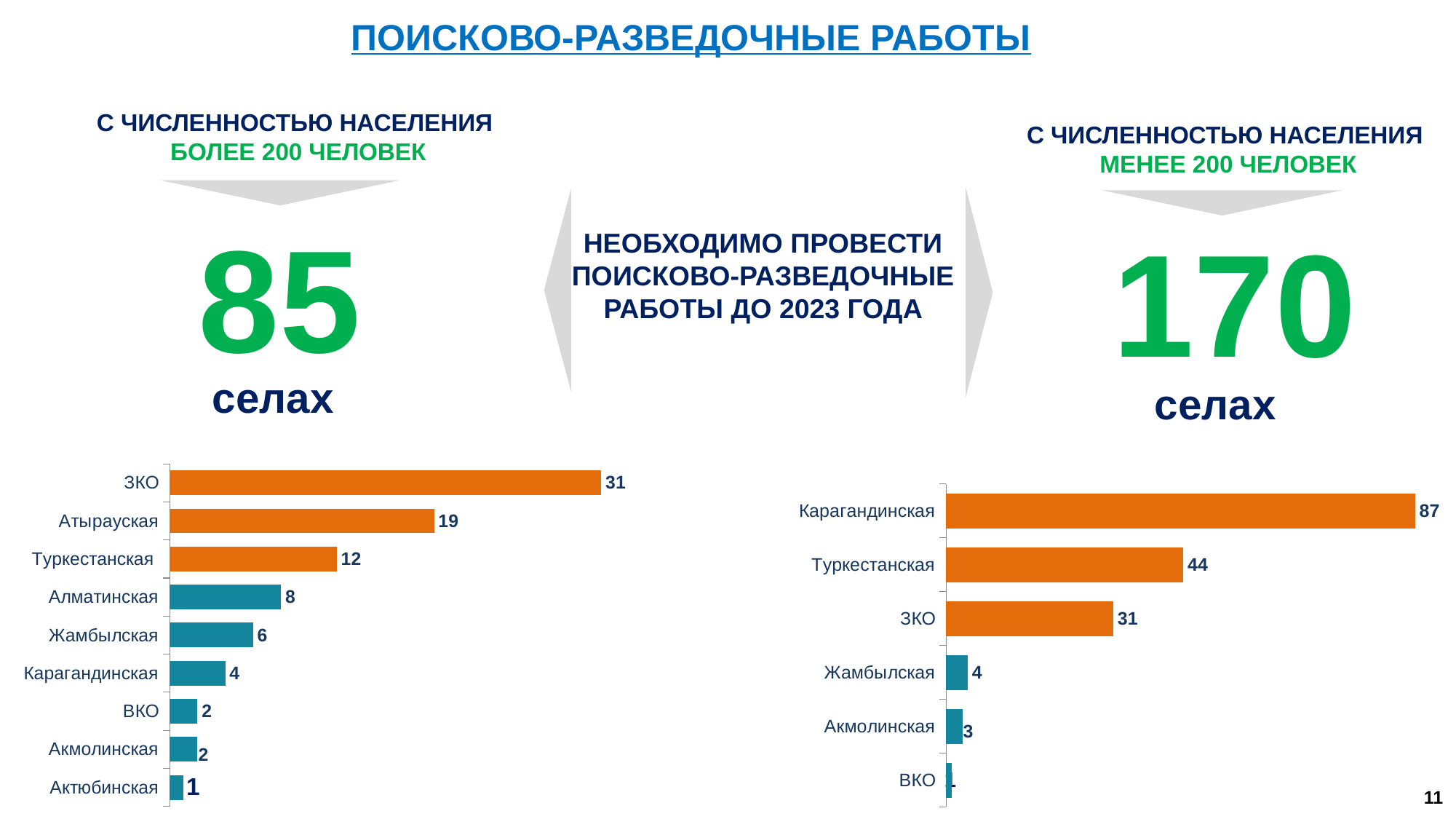
What type of chart is the left chart? Bar chart In the right chart, what is the difference between Карагандинская and Туркестанская? 43 In the right chart, which is larger, ЗКО or Жамбылская? ЗКО In the left chart, which is larger, Алматинская or Жамбылская? Алматинская How many categories are shown in the left chart? 9 In the right chart, which category has the highest value? Карагандинская In the left chart, what is the difference between ЗКО and Туркестанская? 19 How many categories are shown in the right chart? 6 In the right chart, what is the value for Туркестанская? 44 In the left chart, which category has the highest value? ЗКО In the left chart, what is the value for Атырауская? 19 In the left chart, which category has the lowest value? Актюбинская